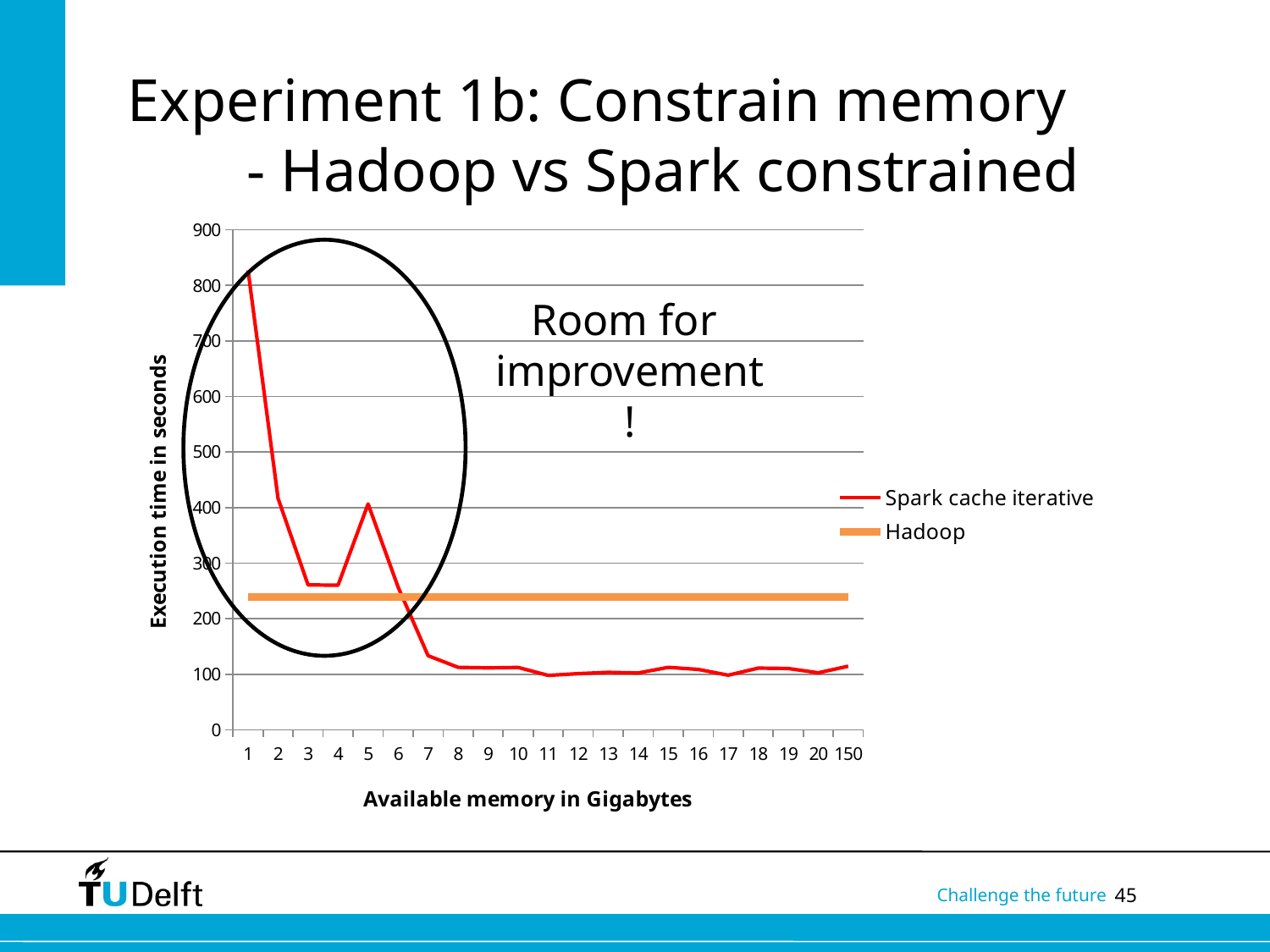
At 2 GB of available memory, which series has the higher execution time, Spark cache iterative or Hadoop? Spark cache iterative How many memory values are labelled along the x axis? 21 Is the Hadoop value greater or less than 300? less Is the Spark cache iterative value at 5 GB greater or less than 300? greater At which available memory value is the Spark cache iterative execution time highest? 1 What are the two series named in the legend? Spark cache iterative and Hadoop Is the Spark cache iterative value at 10 GB greater or less than 200? less What is the title of the y axis? Execution time in seconds What kind of chart is shown on the slide? line chart How many series does the legend list? 2 At 15 GB of available memory, which series has the higher execution time, Spark cache iterative or Hadoop? Hadoop